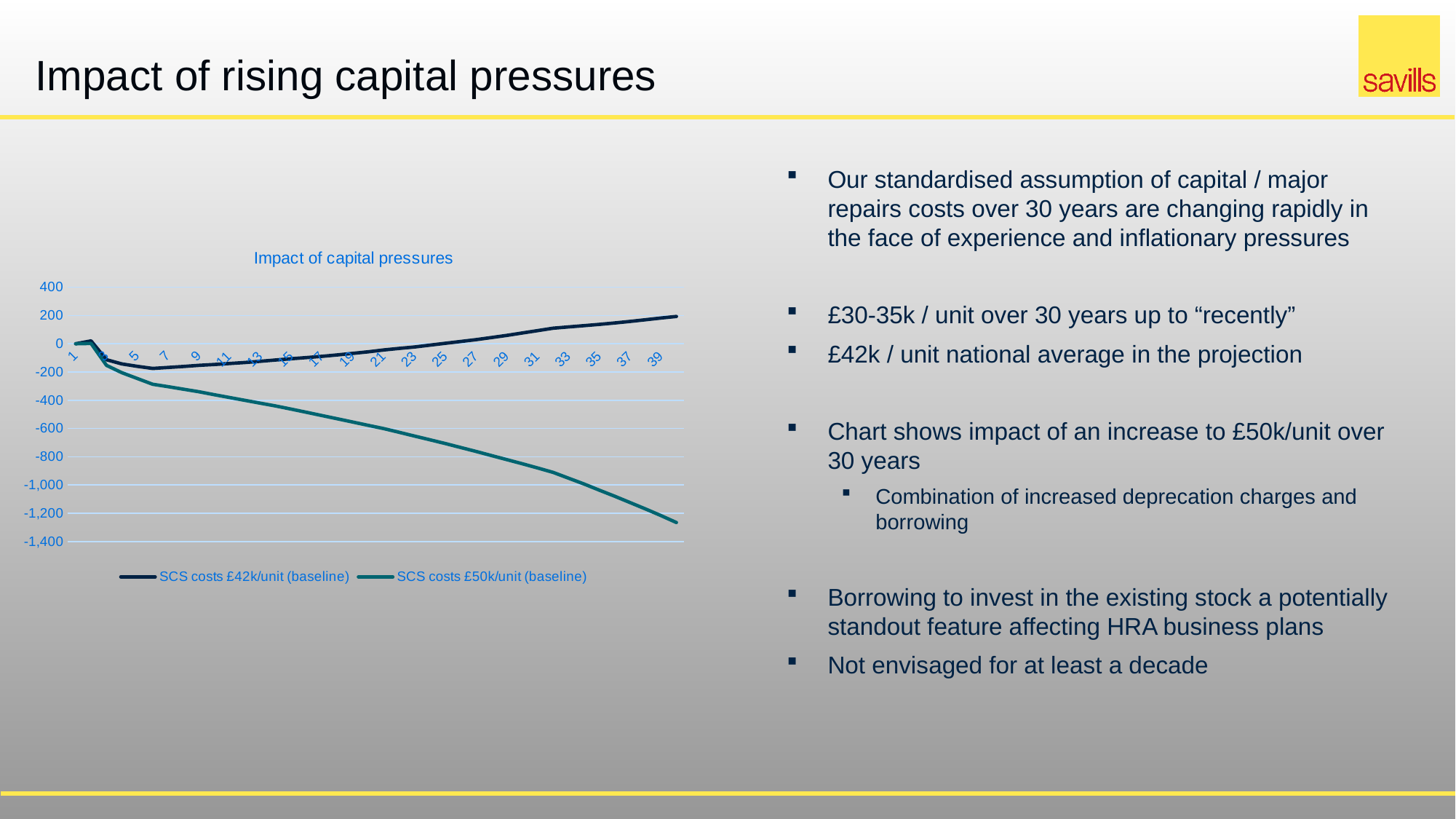
What kind of chart is shown on the slide? line chart How many series does the chart legend list? 2 Is the value of the SCS costs £50k/unit (baseline) line at point 33 greater or less than -800? less Which series reaches the lowest value on the chart? SCS costs £50k/unit (baseline) Is the value of the SCS costs £42k/unit (baseline) line at point 5 greater or less than 0? less Does the SCS costs £42k/unit (baseline) line rise or fall along the x axis from point 5 to point 39? rise Does the SCS costs £50k/unit (baseline) line rise or fall along the x axis after its initial point? fall What is the title of the chart? Impact of capital pressures Is the value of the SCS costs £42k/unit (baseline) line at point 39 greater or less than 0? greater What are the two series named in the chart legend? SCS costs £42k/unit (baseline) and SCS costs £50k/unit (baseline) At point 39, which series has the higher value: SCS costs £42k/unit (baseline) or SCS costs £50k/unit (baseline)? SCS costs £42k/unit (baseline)